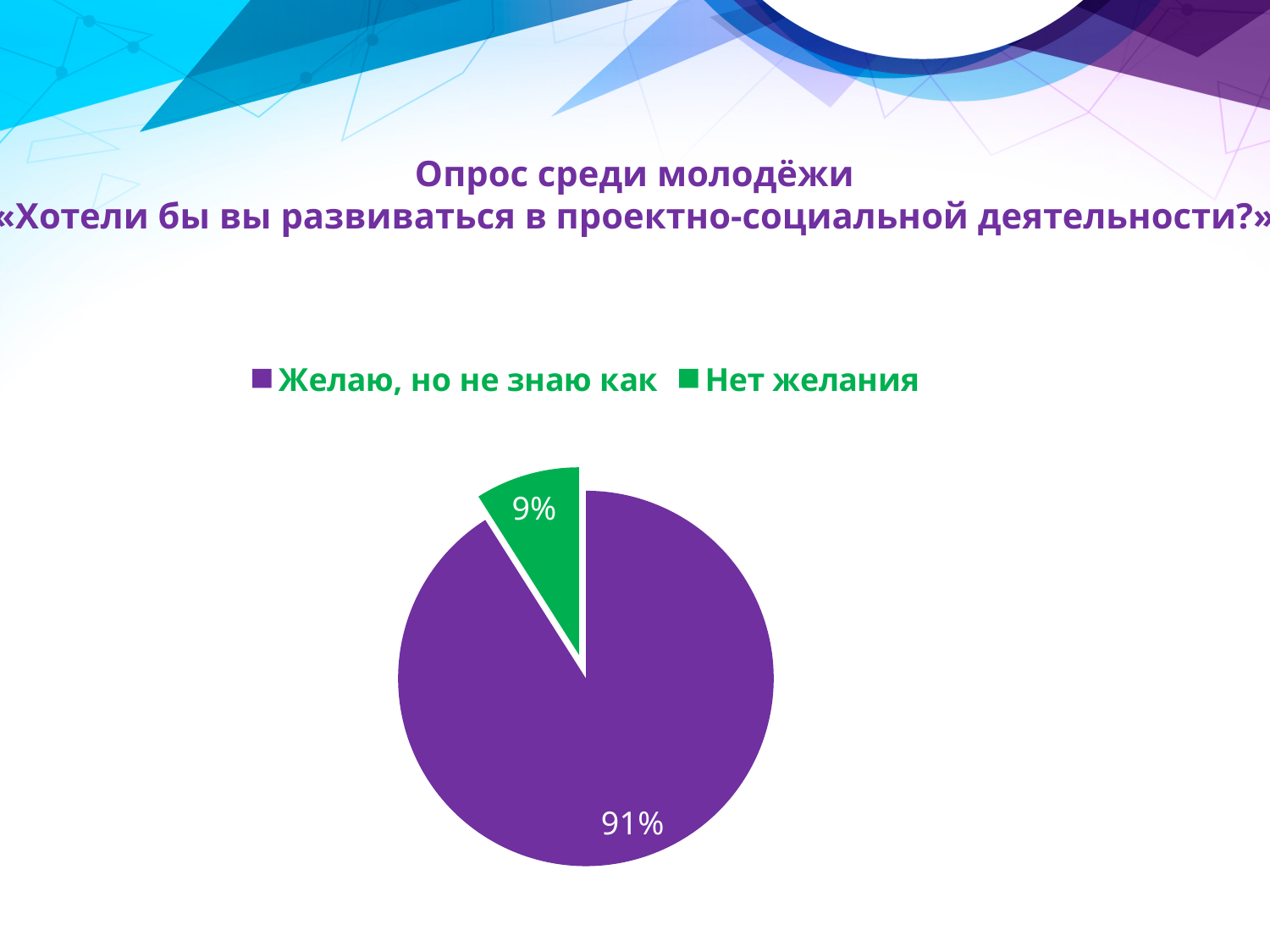
What is the difference in percentage points between the "Желаю, но не знаю как" slice and the "Нет желания" slice? 82 What share of the pie does "Желаю, но не знаю как" take? 91% How many categories does the pie chart show? 2 Which is larger: the "Желаю, но не знаю как" slice or the "Нет желания" slice? Желаю, но не знаю как Which category has the largest slice of the pie? Желаю, но не знаю как What kind of chart is shown on the slide? Pie chart What colour is the "Желаю, но не знаю как" slice? Purple What share of the pie does "Нет желания" take? 9% What colour is the "Нет желания" slice? Green Which category has the smallest slice of the pie? Нет желания How many entries does the legend list? 2